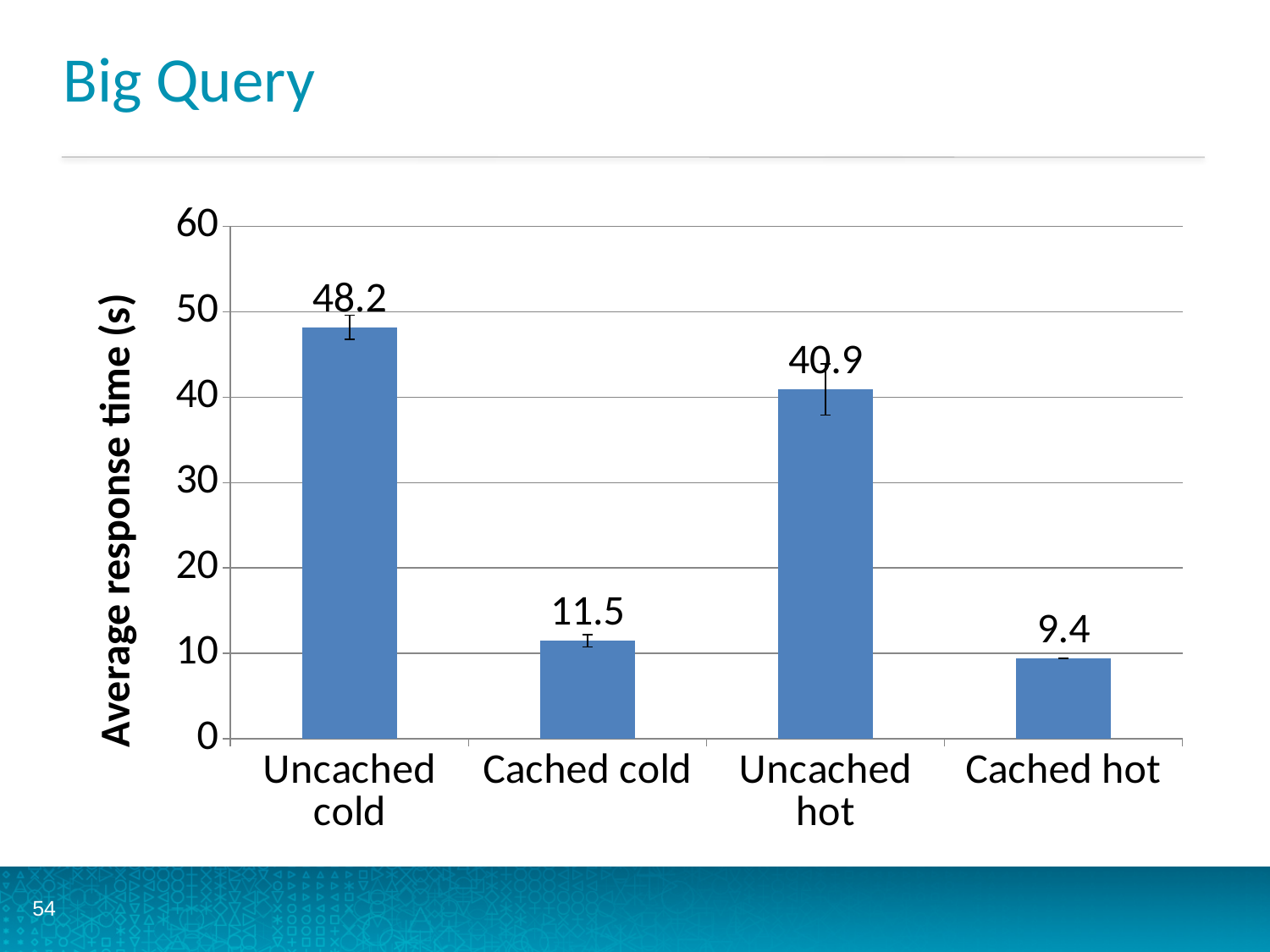
How many categories are shown on the x axis? 4 What is the difference in average response time between Uncached hot and Cached hot? 31.5 What is the difference in average response time between Uncached cold and Cached cold? 36.7 What is the average response time for Uncached cold? 48.2 Is the value for Uncached hot greater or less than 30? greater Which has a larger average response time, Cached cold or Cached hot? Cached cold What is the average response time for Cached hot? 9.4 What kind of chart is shown on the slide? bar chart Which category has the highest average response time? Uncached cold Which category has the lowest average response time? Cached hot What is the average response time for Cached cold? 11.5 What is the average response time for Uncached hot? 40.9